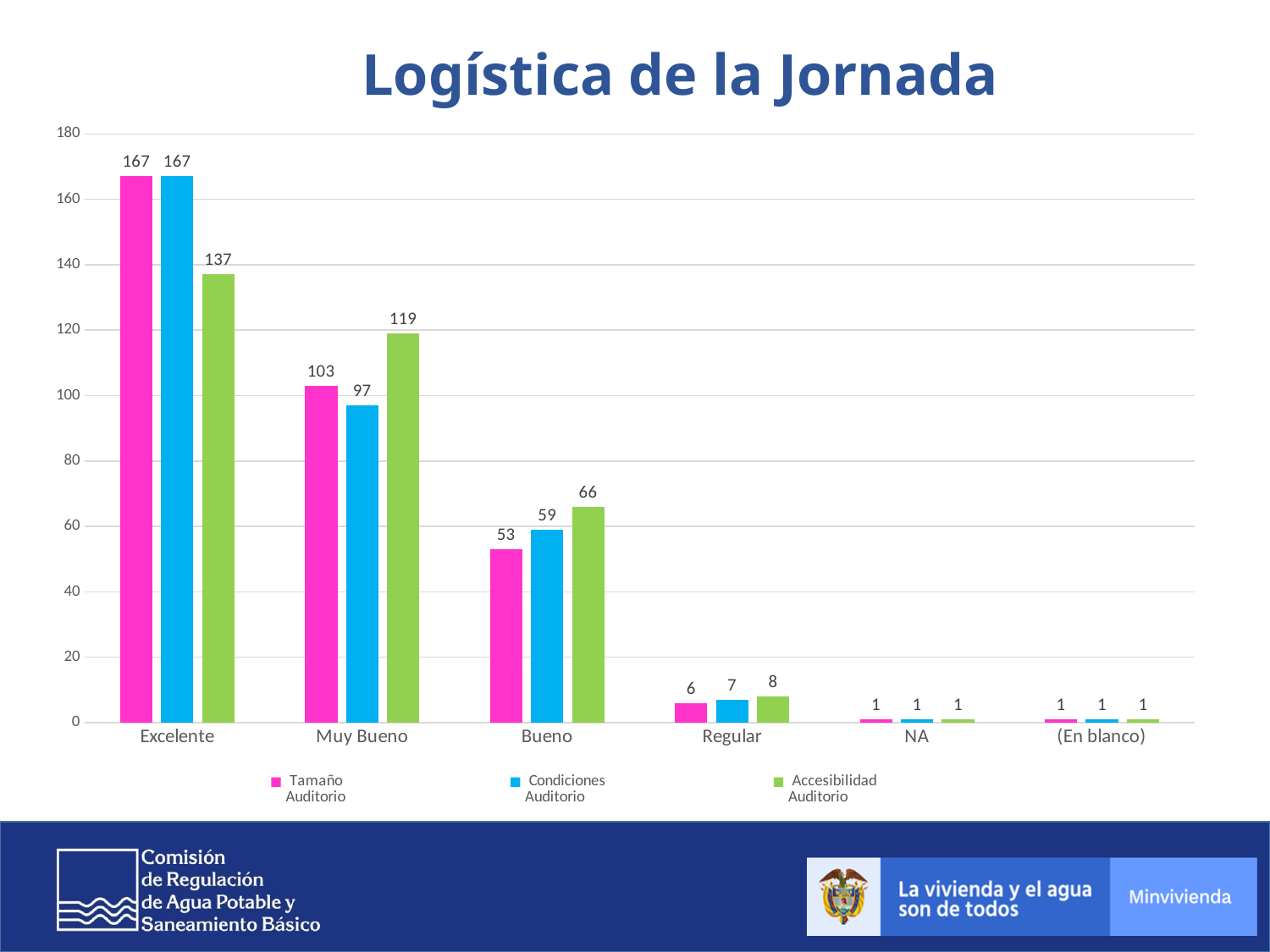
How many categories are shown on the x axis? 6 What is the value for Condiciones Auditorio in the Bueno category? 59 What is the difference between Tamaño Auditorio and Condiciones Auditorio in the Muy Bueno category? 6 What is the title of the chart? Logística de la Jornada Is the value for Accesibilidad Auditorio in the Excelente category greater or less than 140? less What is the value for Tamaño Auditorio in the Excelente category? 167 How many series does the legend list? 3 What is the value for Accesibilidad Auditorio in the Muy Bueno category? 119 Which category has the lowest value for Tamaño Auditorio? NA and (En blanco) What kind of chart is shown on the slide? Bar chart In the Bueno category, which is larger: Tamaño Auditorio or Accesibilidad Auditorio? Accesibilidad Auditorio Which category has the highest value for Accesibilidad Auditorio? Excelente